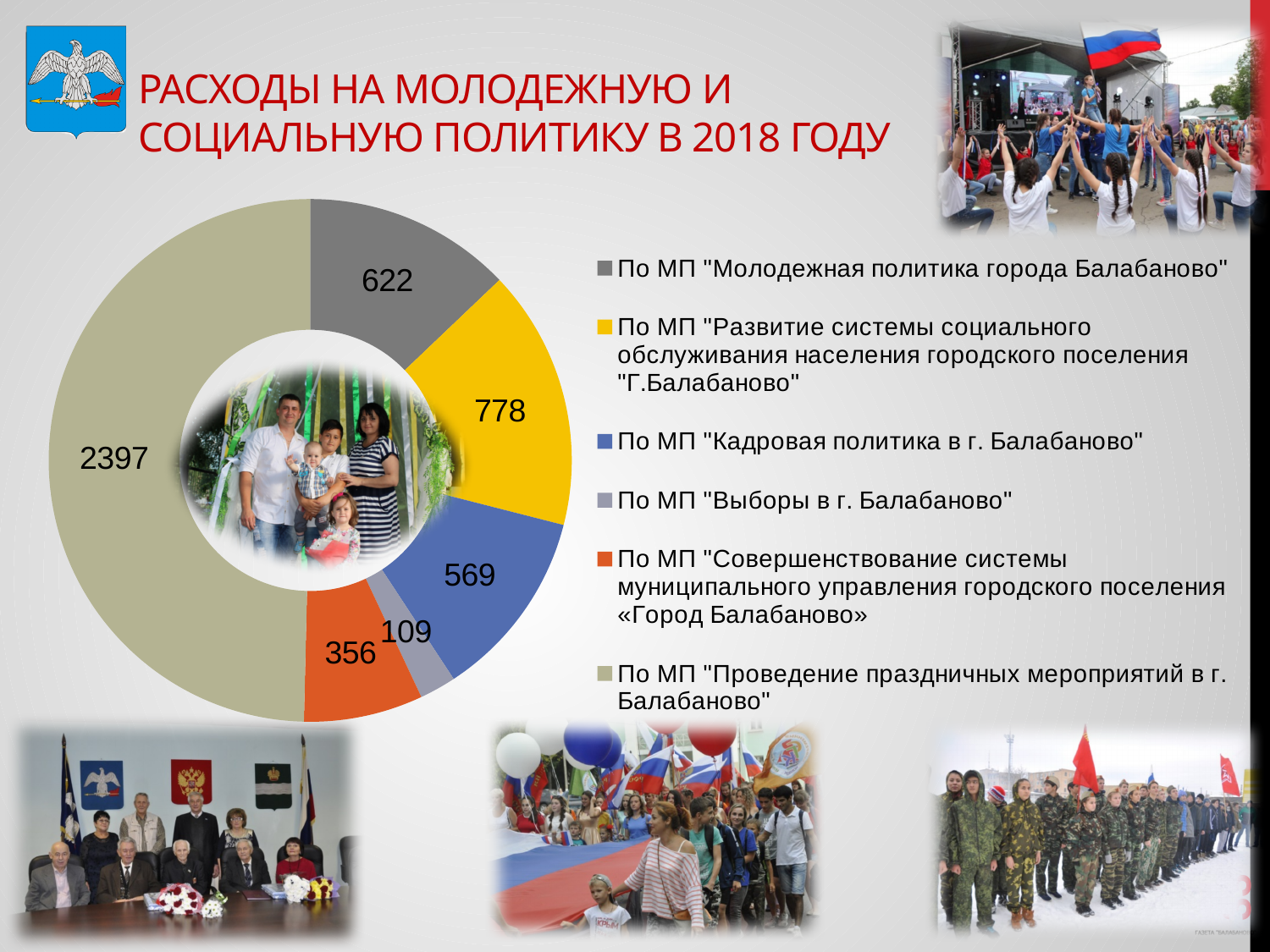
What is the total of all the values shown in the chart? 4831 What kind of chart is shown on the slide? Doughnut (pie) chart Which program has the largest segment in the chart? По МП "Проведение праздничных мероприятий в г. Балабаново" How many entries does the legend list? 6 What is the difference between the value for "Развитие системы социального обслуживания" (778) and the value for "Молодежная политика города Балабаново" (622)? 156 What value is shown for the segment "По МП "Кадровая политика в г. Балабаново""? 569 What value is shown for the segment "По МП "Проведение праздничных мероприятий в г. Балабаново""? 2397 How many segments does the chart have? 6 What value is shown for the segment "По МП "Выборы в г. Балабаново""? 109 Which is larger: the value for "Кадровая политика в г. Балабаново" or the value for "Совершенствование системы муниципального управления"? Кадровая политика в г. Балабаново Which program has the smallest segment in the chart? По МП "Выборы в г. Балабаново" What value is shown for the segment "По МП "Молодежная политика города Балабаново""? 622